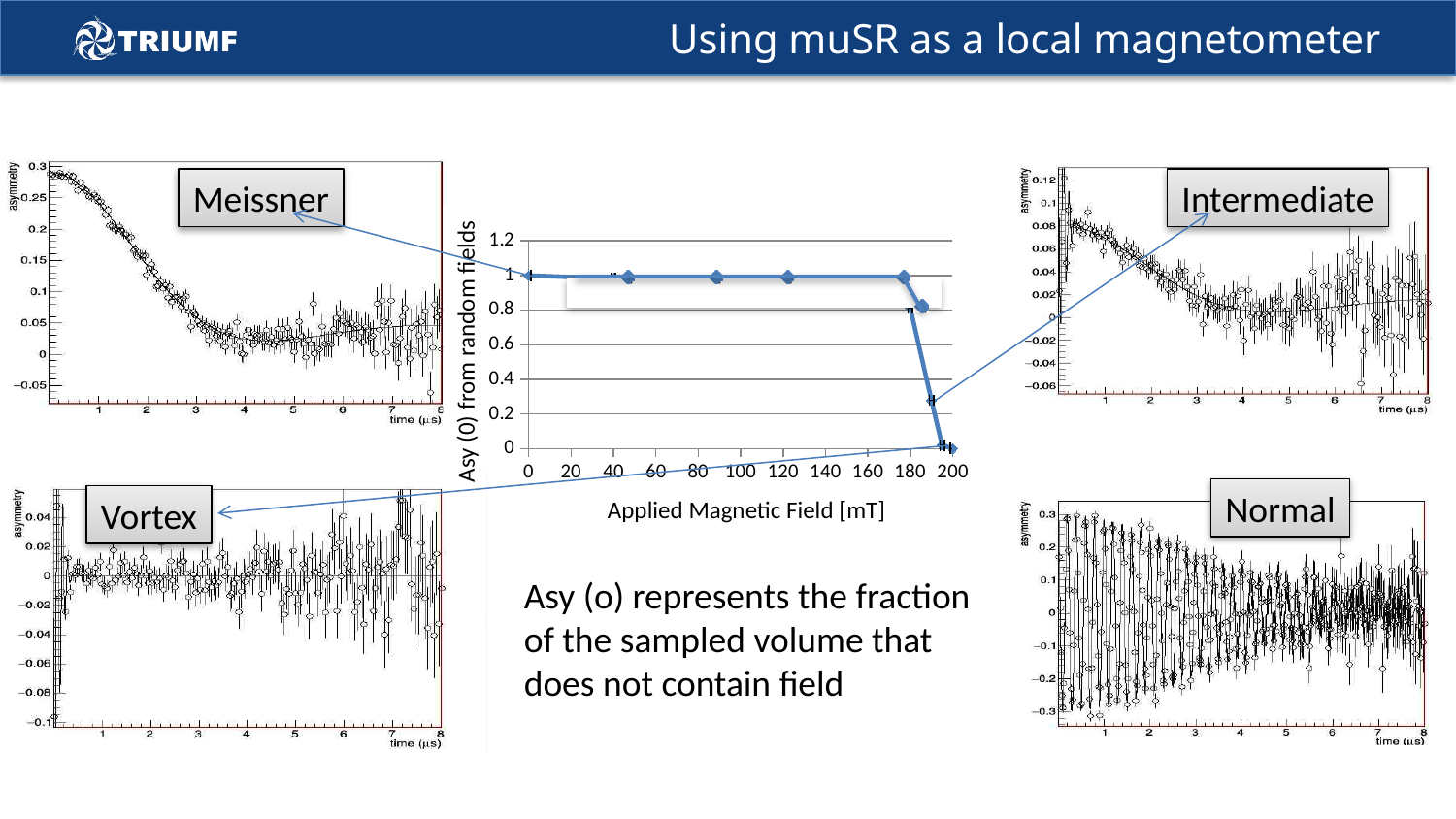
What is the label of the x axis of the central chart? Applied Magnetic Field [mT] In the central chart, do the values of Asy (0) from random fields rise or fall as the applied magnetic field increases along the x axis? fall What is the highest tick value shown on the x axis of the central chart? 200 In the central chart, is the value of Asy (0) at an applied field of 0 mT greater or less than 0.8? greater In the central chart, is the value of Asy (0) at an applied field of 200 mT greater or less than 0.2? less What kind of chart is the central chart of Asy (0) from random fields versus Applied Magnetic Field? line chart In the central chart, is the value of Asy (0) at an applied field of 120 mT greater or less than 0.6? greater In the central chart, which has the larger Asy (0) value: the point at 0 mT or the point at 200 mT? 0 mT How many labelled regime plots (Meissner, Vortex, Intermediate, Normal) surround the central chart? 4